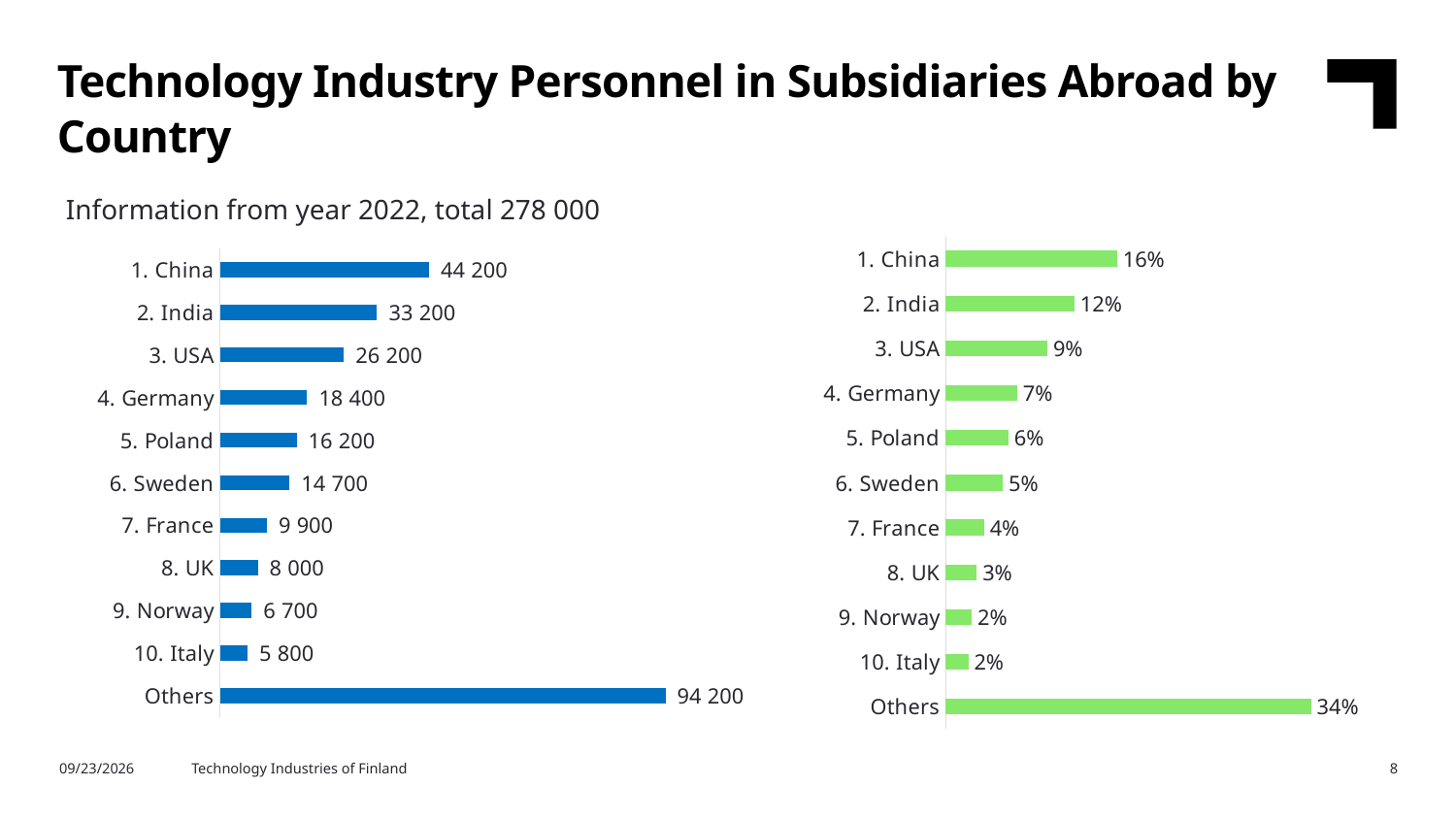
What kind of chart is the right chart? Bar chart In the left chart, which category has the lowest value? 10. Italy In the right chart, what is the percentage for Others? 34% In the right chart, what is the difference between the percentages for 1. China and 4. Germany? 9% In the left chart, what is the difference between the values for 1. China and 2. India? 11 000 In the right chart, what is the percentage for 3. USA? 9% In the left chart, what is the value for 5. Poland? 16 200 In the left chart, which is larger, the value for 6. Sweden or the value for 7. France? 6. Sweden In the left chart, which category has the highest value? Others What total is stated in the subtitle of the slide? 278 000 How many categories are shown in the left chart? 11 In the left chart, what is the value for 1. China? 44 200